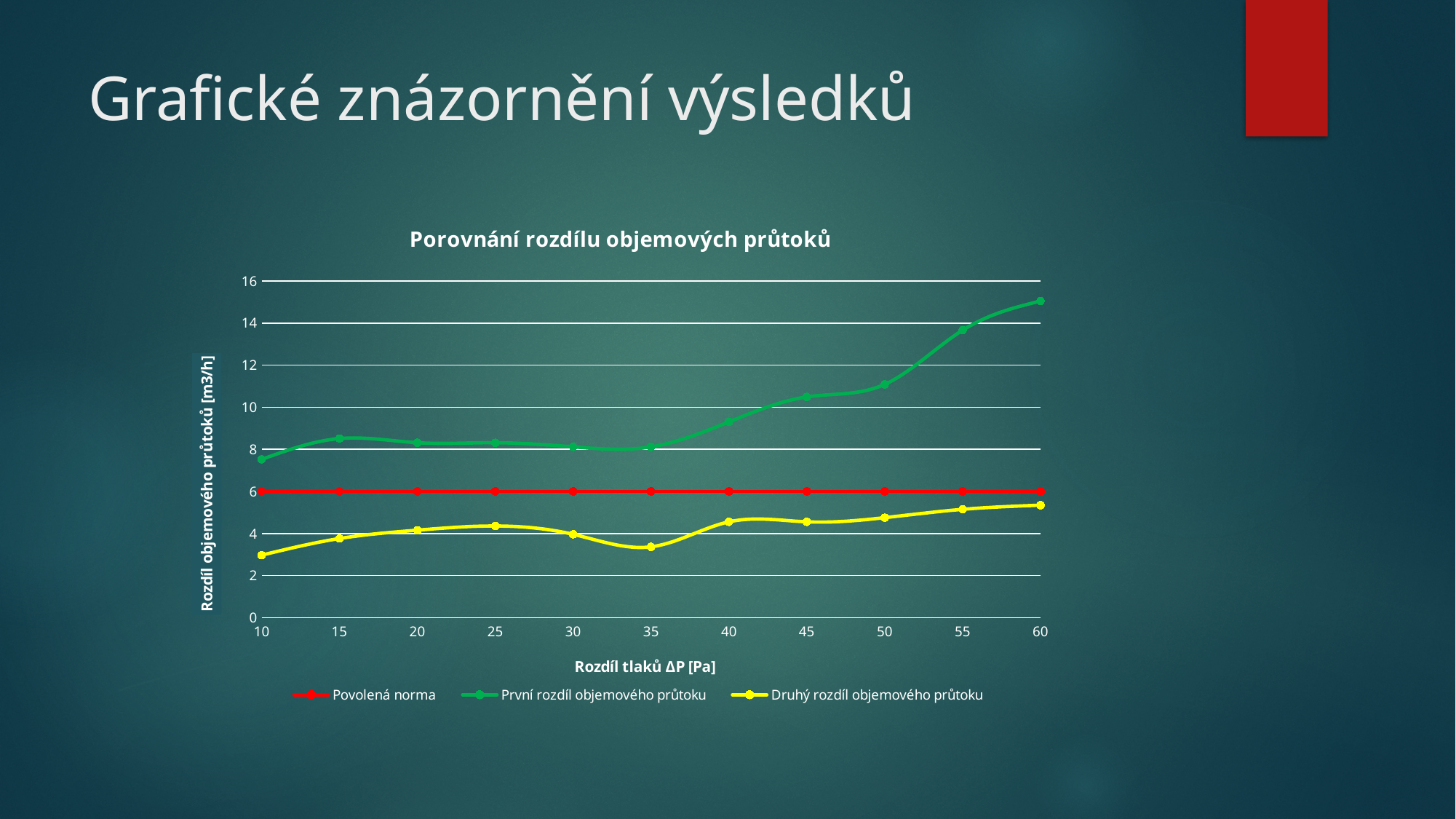
Is the value for Druhý rozdíl objemového průtoku at 35 Pa greater or less than 4? less At 60 Pa, which is larger: První rozdíl objemového průtoku or Druhý rozdíl objemového průtoku? První rozdíl objemového průtoku What kind of chart is shown on the slide? line chart How many series does the legend list? 3 How many pressure-difference values are plotted along the x axis? 11 Is the value for První rozdíl objemového průtoku at 60 Pa greater or less than 14? greater What is the value of Povolená norma at 10 Pa? 6 Which series is drawn in red? Povolená norma Is the value for První rozdíl objemového průtoku at 10 Pa greater or less than 8? less What is the title of the chart? Porovnání rozdílu objemových průtoků Does the value of První rozdíl objemového průtoku rise or fall from 35 Pa to 60 Pa? rises Which series has the highest value at 60 Pa? První rozdíl objemového průtoku